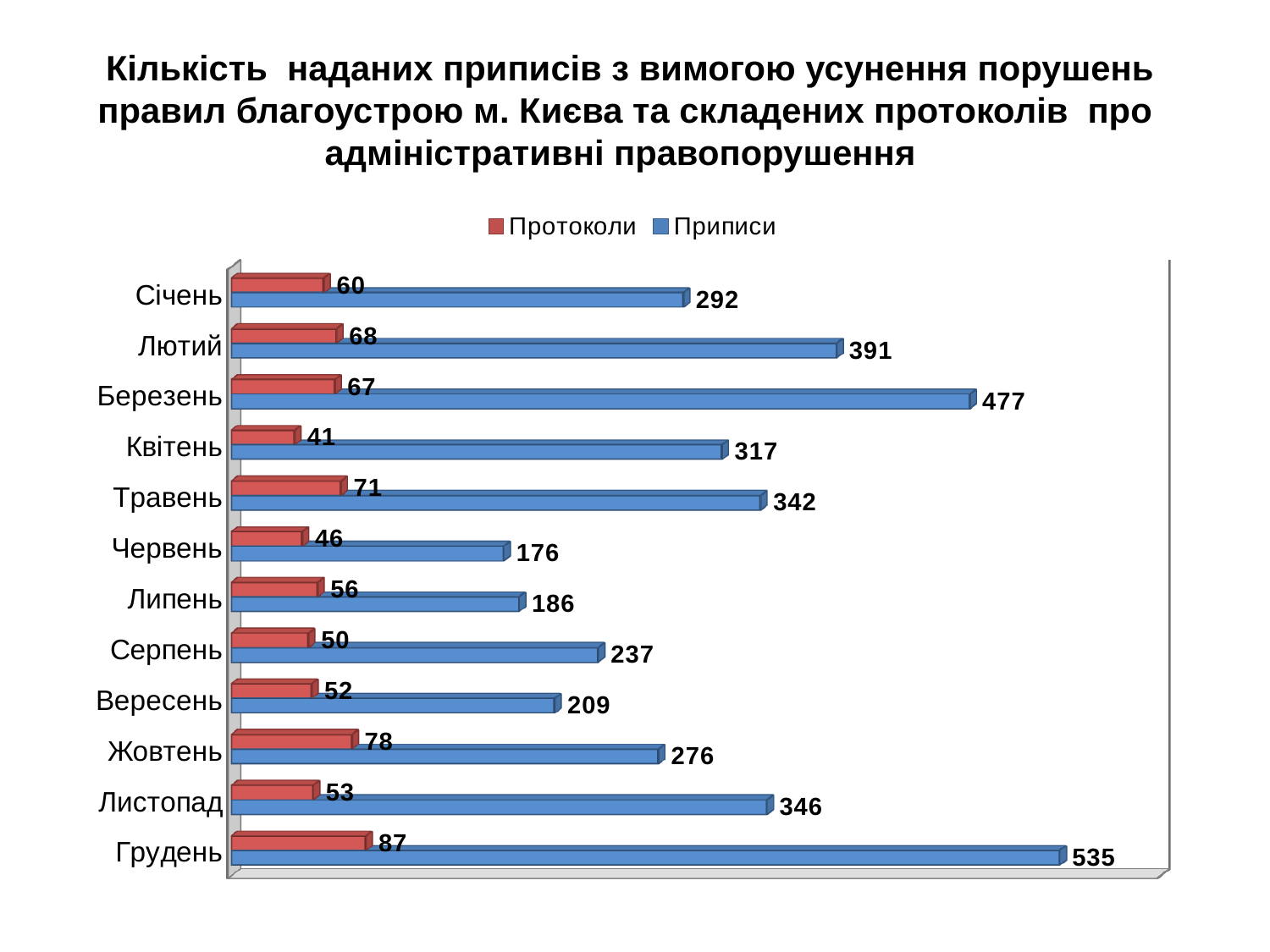
Which series is shown in blue? Приписи What kind of chart is shown on the slide? Bar chart Which month has the lowest value for Протоколи? Квітень Which month has the lowest value for Приписи? Червень How many months are shown on the chart? 12 What is the value of Приписи for Березень? 477 What is the difference between the Приписи values for Грудень and Січень? 243 Which month has the highest value for Протоколи? Грудень Which month has the highest value for Приписи? Грудень How many series does the legend list? 2 Which is larger: the Приписи value for Лютий or for Травень? Лютий What is the value of Протоколи for Жовтень? 78